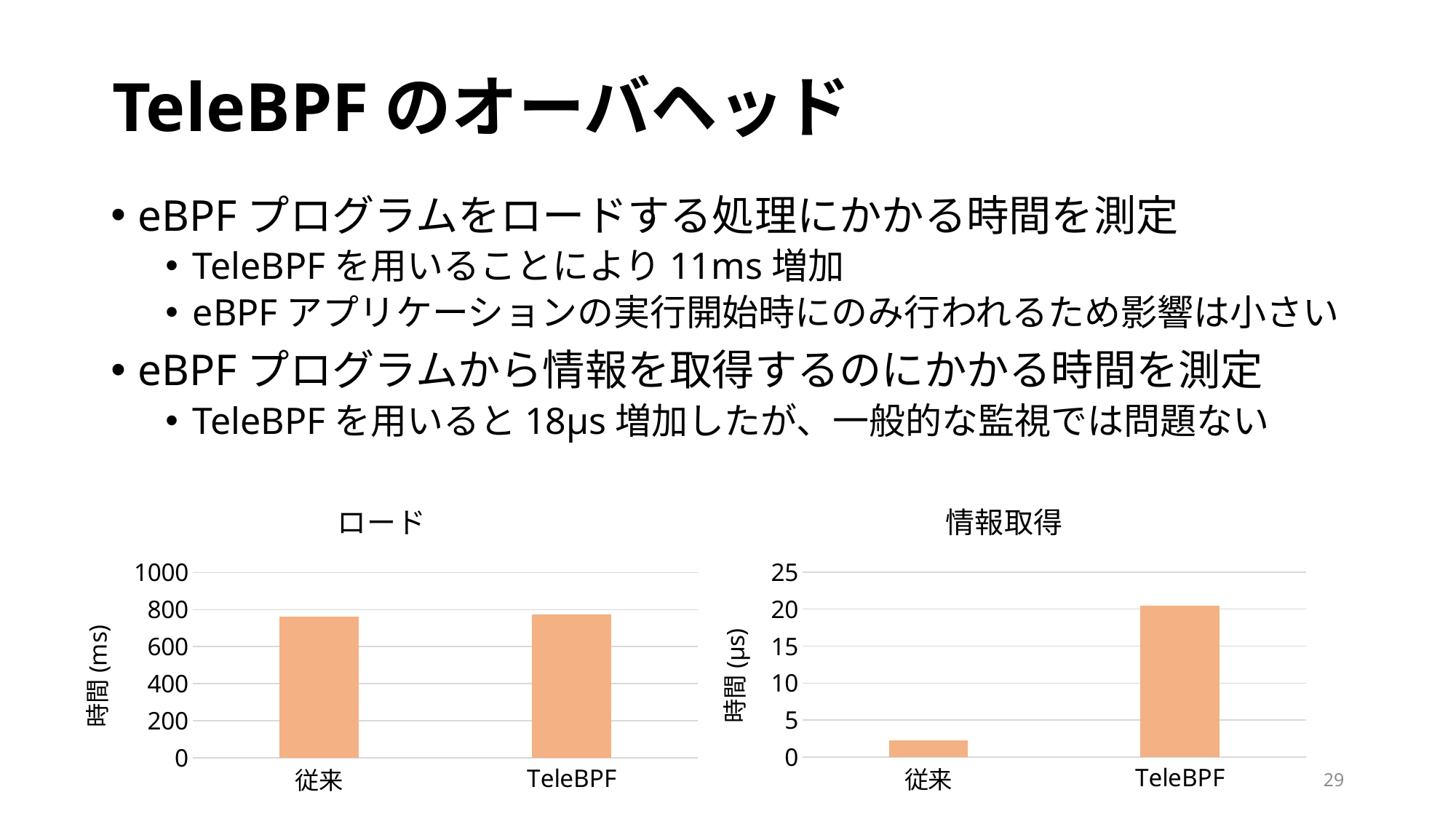
What kind of chart is the "ロード" chart? bar chart How many bars are plotted in the "情報取得" chart? 2 In the "情報取得" chart, which category has the lowest value? 従来 In the "ロード" chart, is the value for TeleBPF greater or less than 800? less How many categories are shown on the x axis of the "ロード" chart? 2 What is the y-axis title of the "ロード" chart? 時間 (ms) In the "情報取得" chart, is the value for TeleBPF greater or less than 20? greater In the "ロード" chart, is the value for 従来 greater or less than 600? greater In the "情報取得" chart, which category has the highest value? TeleBPF In the "情報取得" chart, which is larger, the value for 従来 or the value for TeleBPF? TeleBPF What kind of chart is the "情報取得" chart? bar chart